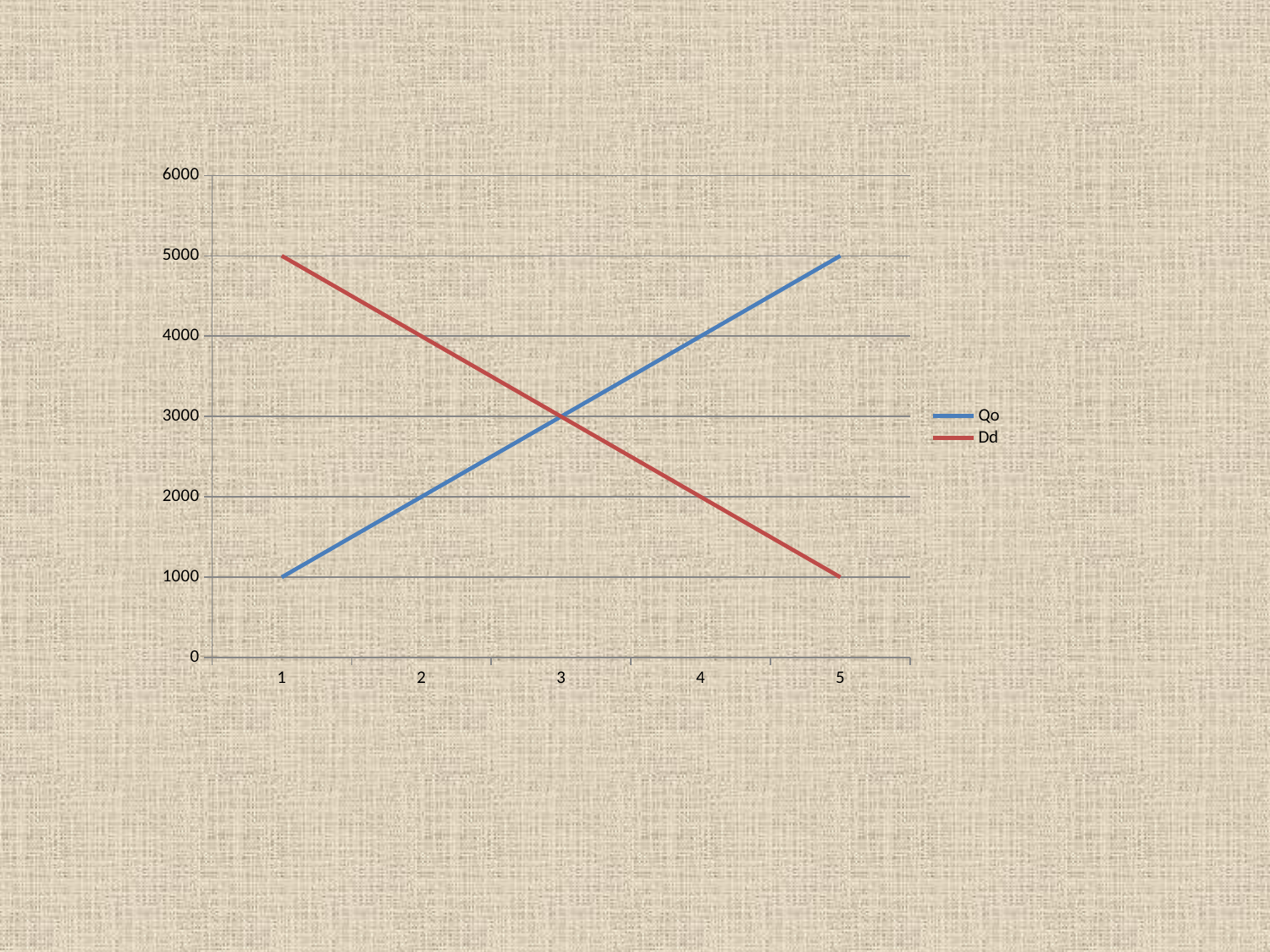
What is the value of Qo at x = 1? 1000 Which series has the larger value at x = 4, Qo or Dd? Qo Do the values of Qo rise or fall as x increases from 1 to 5? rise How many points are plotted along the x axis for each series? 5 What is the value of Dd at x = 5? 1000 What is the difference between the Qo value at x = 5 and the Qo value at x = 1? 4000 Which colour is used for the Dd series? red What is the value of Dd at x = 1? 5000 Do the values of Dd rise or fall as x increases from 1 to 5? fall What is the value of Qo at x = 5? 5000 What kind of chart is shown on the slide? line chart How many series does the legend list? 2